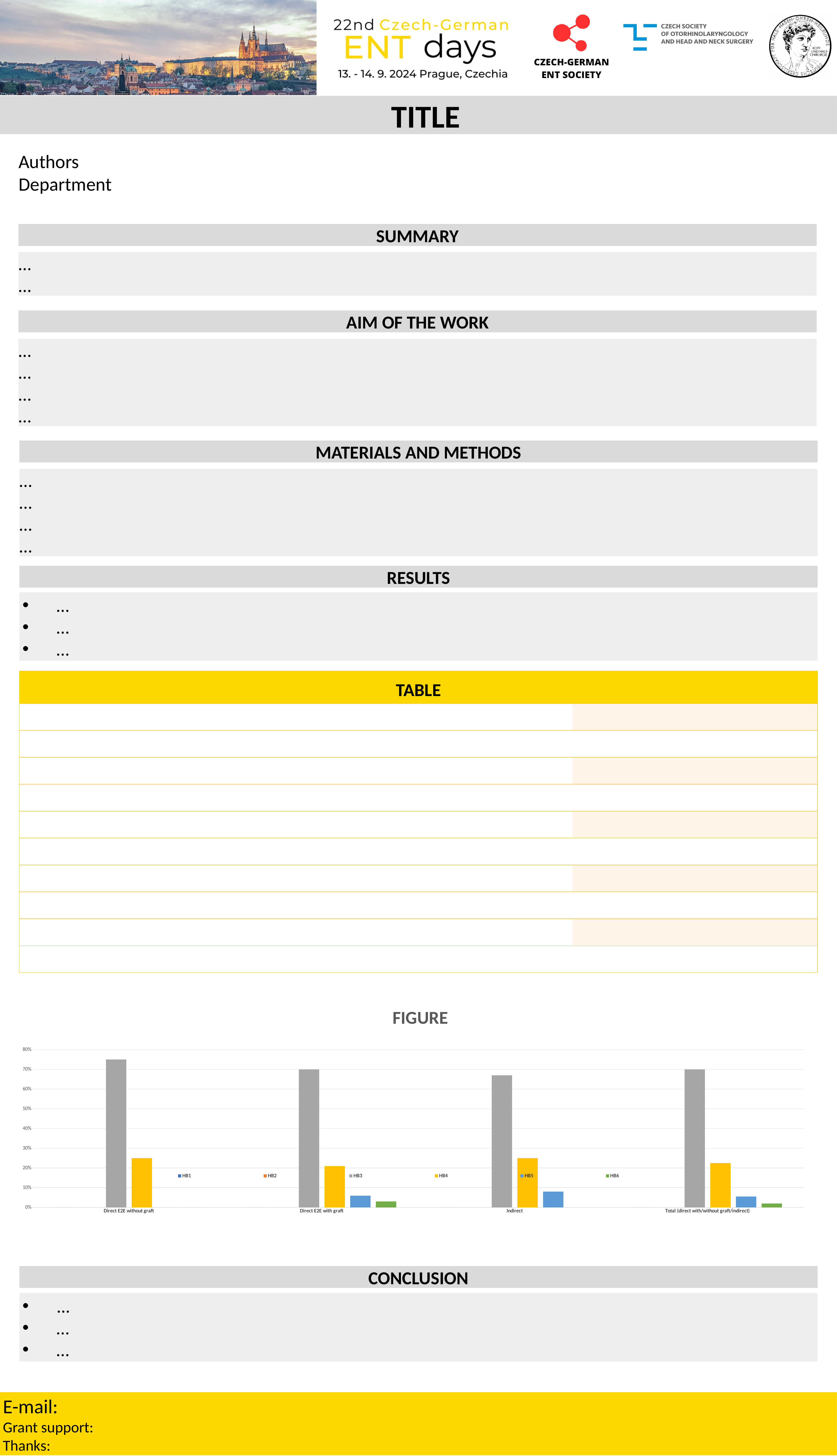
How many categories are shown on the x axis of the chart? 4 What is the first entry listed in the chart's legend? HB1 For the Total (direct with/without graft/indirect) category, which is larger, the HB5 bar or the HB6 bar? HB5 Is the HB3 value for Direct E2E without graft greater or less than 70%? greater In which category is the HB3 bar the highest? Direct E2E without graft Is the HB3 value for Indirect greater or less than 70%? less For the Indirect category, which is larger, the HB3 bar or the HB4 bar? HB3 Is the HB3 value for Direct E2E with graft greater or less than 60%? greater Which series is the tallest bar in every category of the chart? HB3 What kind of chart is shown under the FIGURE heading? bar chart How many series does the chart's legend list? 6